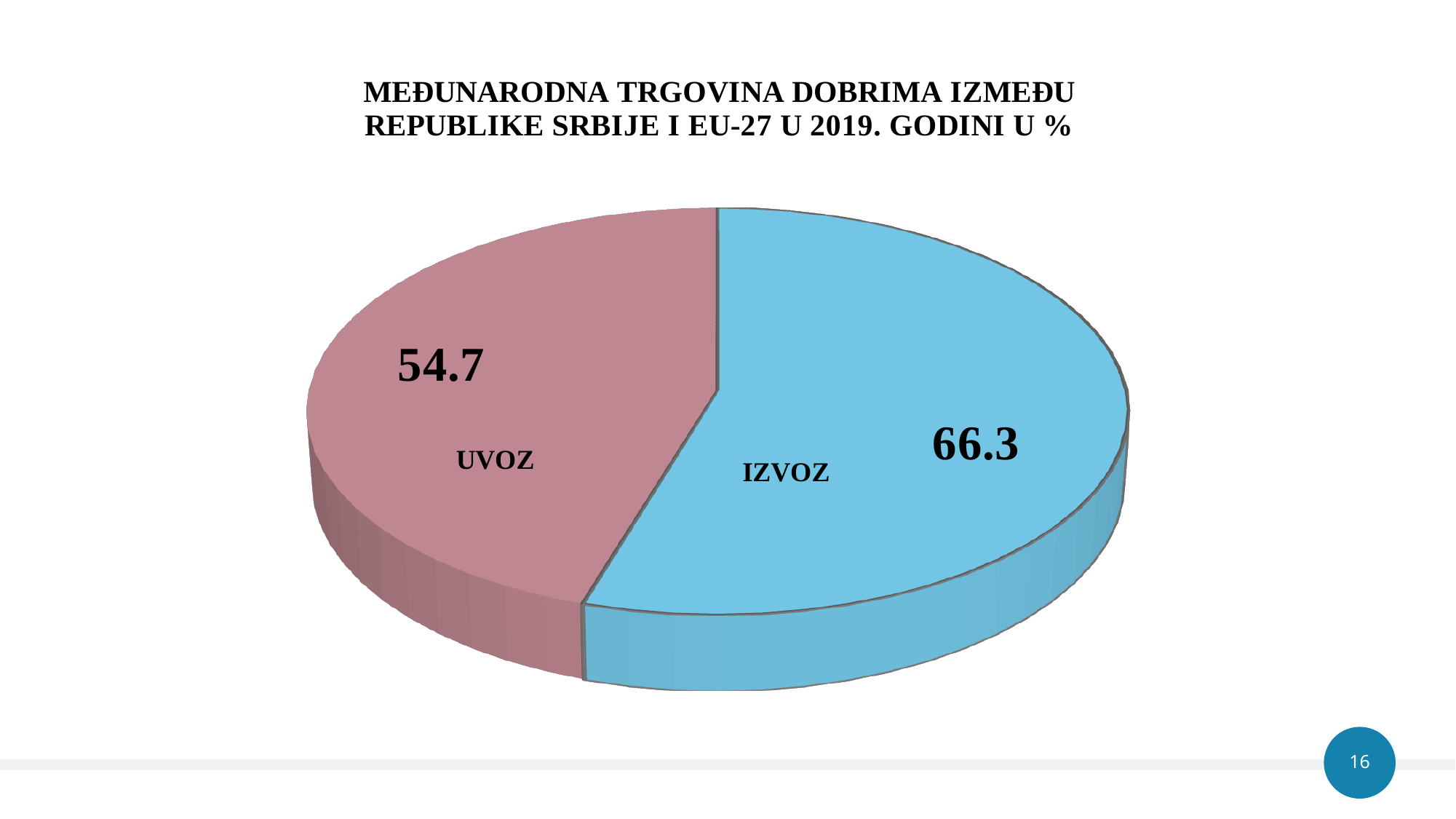
What value is shown for the IZVOZ slice? 66.3 Which slice has the smaller value? UVOZ What colour is the IZVOZ slice? blue What is the difference between the IZVOZ value and the UVOZ value? 11.6 How many slices does the pie chart have? 2 What type of chart is shown on the slide? pie chart Is the value for IZVOZ larger or smaller than the value for UVOZ? larger Which slice has the larger value? IZVOZ What value is shown for the UVOZ slice? 54.7 Which year does the chart title refer to? 2019